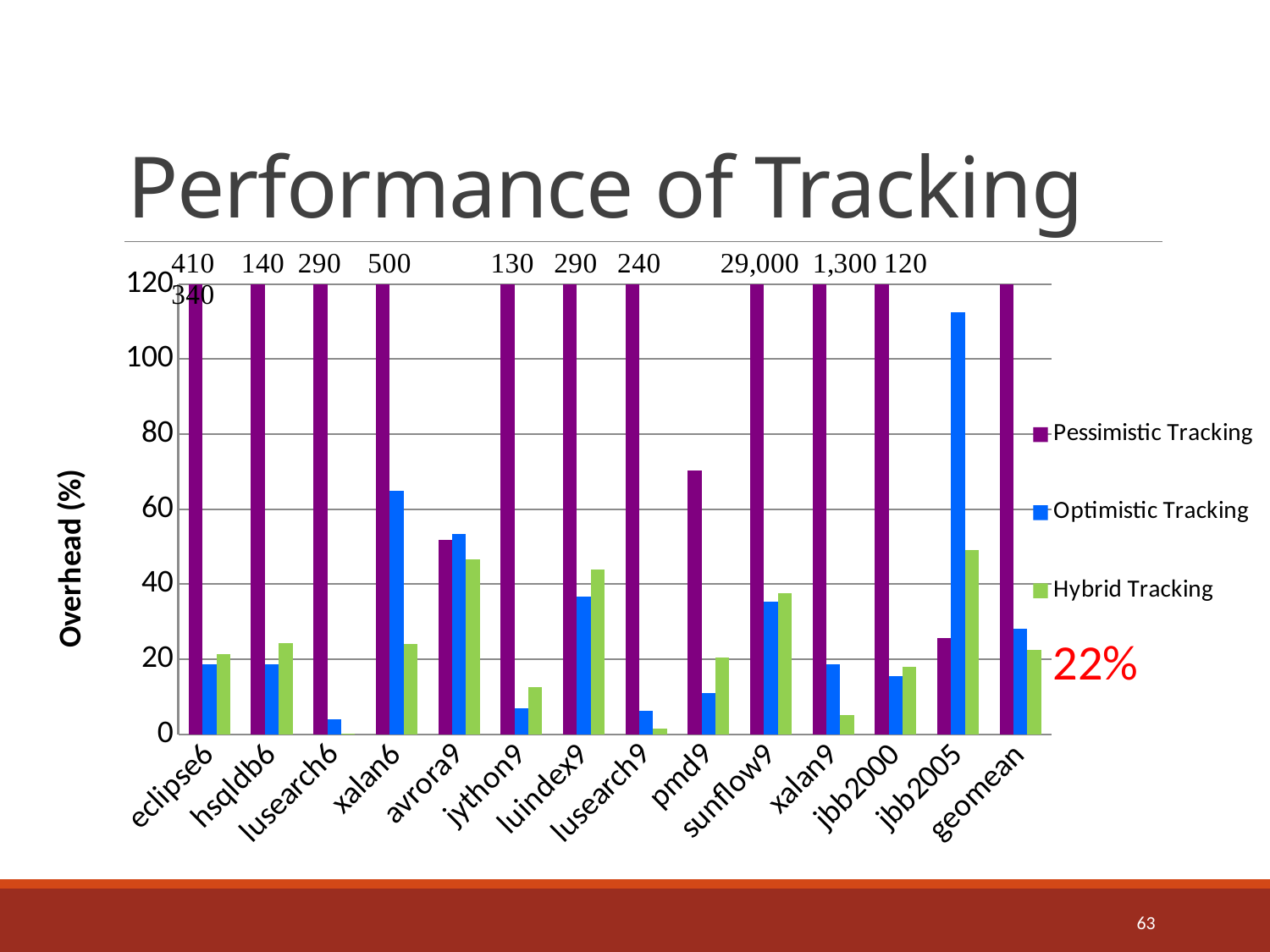
What is the title of the y axis? Overhead (%) For jbb2005, which is larger: Optimistic Tracking or Hybrid Tracking? Optimistic Tracking What is the Pessimistic Tracking overhead for sunflow9, as printed above the chart? 29,000 How many benchmark categories are plotted along the x axis? 14 Is the Optimistic Tracking value for jbb2005 greater or less than 100? greater Which category has the highest Optimistic Tracking overhead? jbb2005 For luindex9, which is larger: Optimistic Tracking or Hybrid Tracking? Hybrid Tracking Is the Optimistic Tracking value for xalan6 greater or less than 60? greater What is the Pessimistic Tracking overhead for xalan9, as printed above the chart? 1,300 How many series does the legend list? 3 Is the Pessimistic Tracking value for avrora9 greater or less than 60? less What kind of chart is shown on the slide? bar chart